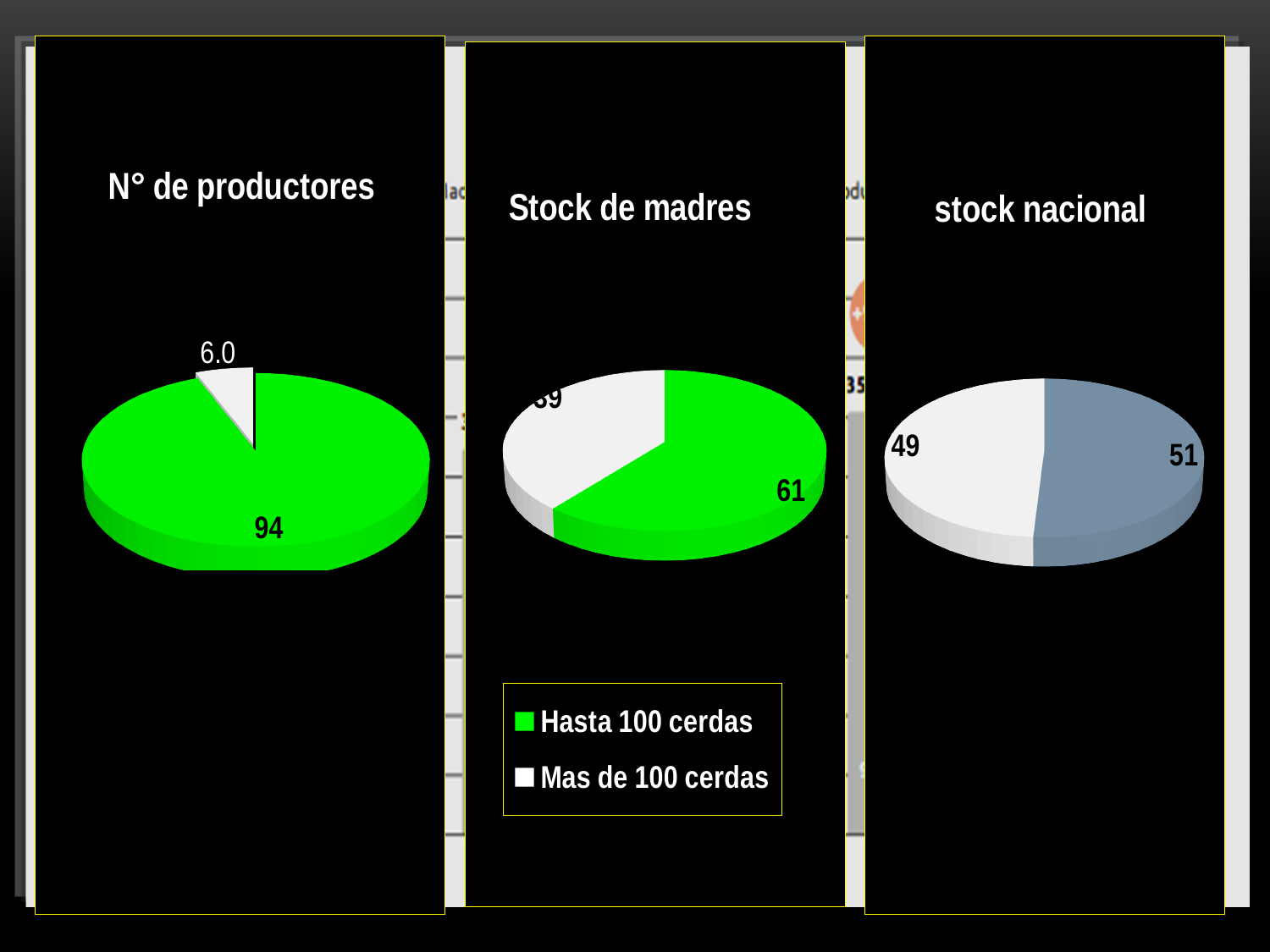
In the "stock nacional" chart, what is the difference between the blue-grey slice (51) and the white slice (49)? 2 In the "Stock de madres" chart, what value is shown for the green "Hasta 100 cerdas" slice? 61 In the "N° de productores" chart, what value is shown for the green "Hasta 100 cerdas" slice? 94 How many entries does the legend under the "Stock de madres" chart list? 2 In the "N° de productores" chart, what value is shown for the white "Mas de 100 cerdas" slice? 6.0 In the "N° de productores" chart, which slice is the largest? the green slice (94) In the "stock nacional" chart, what value is shown for the white slice? 49 In the "stock nacional" chart, what value is shown for the blue-grey slice? 51 What kind of chart is the "N° de productores" chart? pie chart In the "Stock de madres" chart, which slice is larger, "Hasta 100 cerdas" or "Mas de 100 cerdas"? Hasta 100 cerdas In the legend under the "Stock de madres" chart, what colour represents "Hasta 100 cerdas"? green How many pie charts are shown on the slide? 3